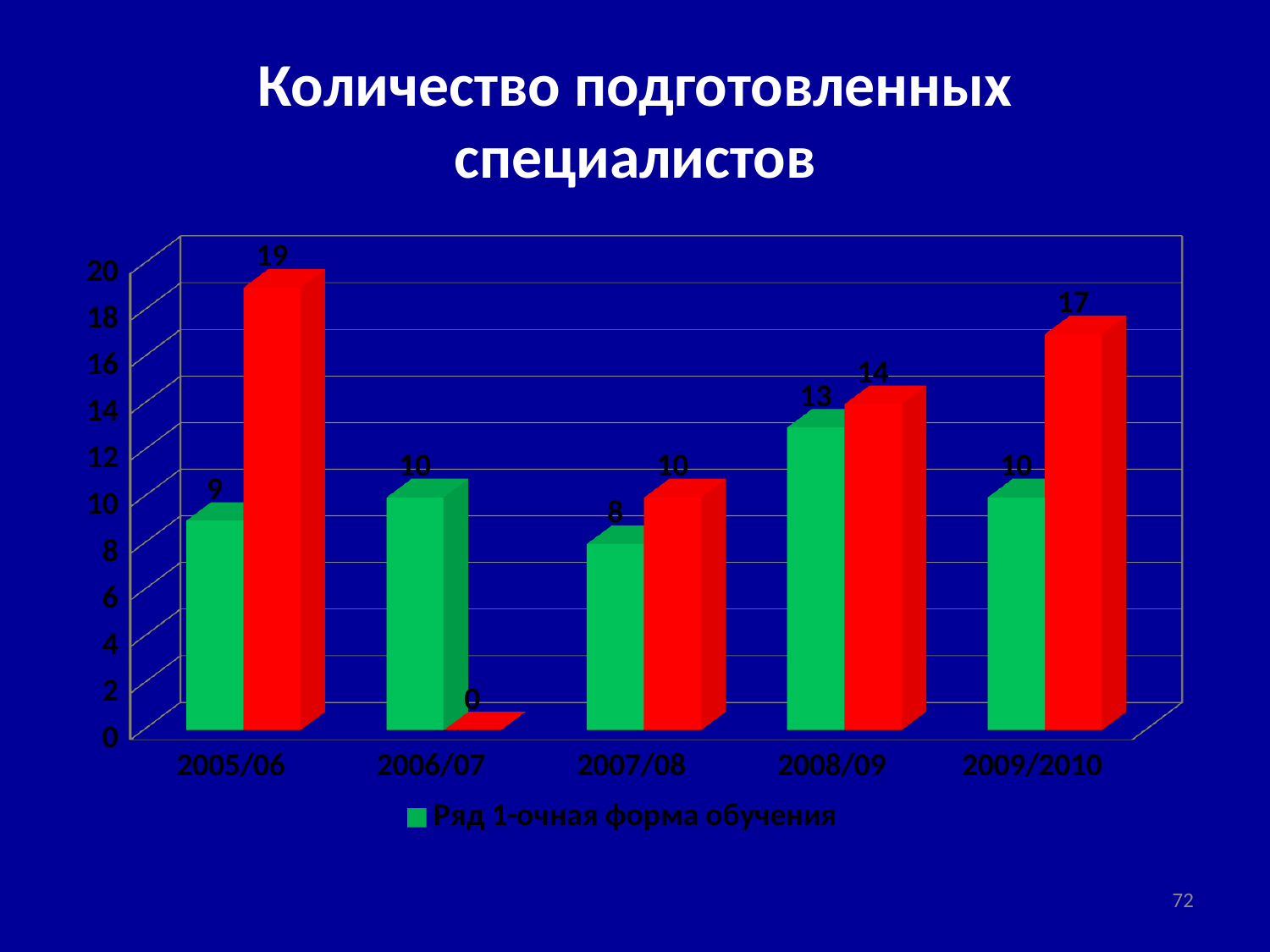
What is the value of the red bar for 2006/07? 0 What is the value of the green bar (Ряд 1-очная форма обучения) for 2007/08? 8 What kind of chart is shown on the slide? bar chart What is the value of the green bar (Ряд 1-очная форма обучения) for 2008/09? 13 How many year categories are shown on the x axis? 5 For 2006/07, which is larger: the green bar or the red bar? the green bar In which year is the green series (Ряд 1-очная форма обучения) lowest? 2007/08 In which year does the red series reach its highest value? 2005/06 What is the difference between the red bar and the green bar for 2009/2010? 7 How many series does the legend list? 1 What is the value of the red bar for 2005/06? 19 What is the title of the chart? Количество подготовленных специалистов